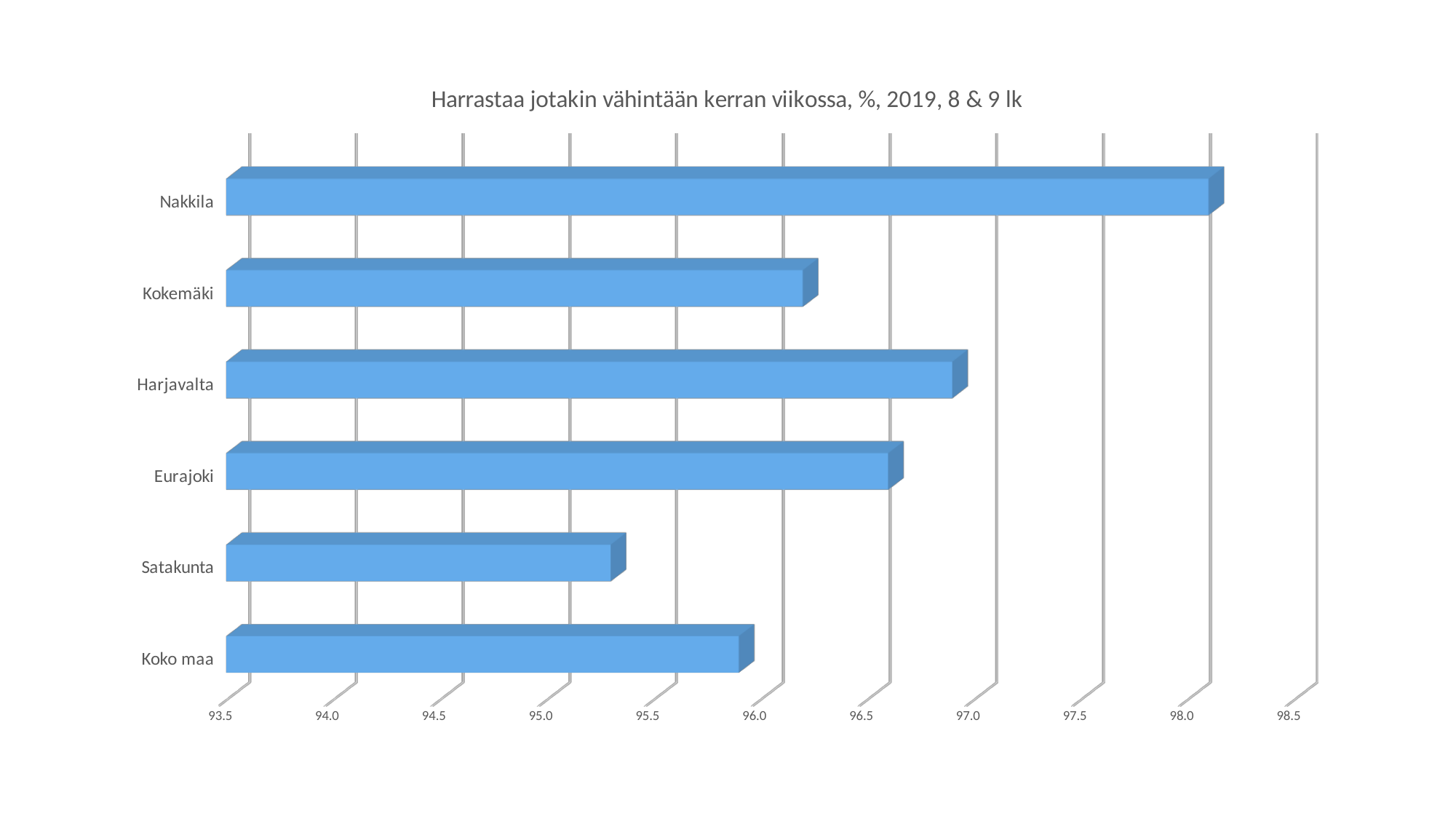
Is the value for Kokemäki greater or less than 96.5? less What is the title of the chart? Harrastaa jotakin vähintään kerran viikossa, %, 2019, 8 & 9 lk Is the value for Nakkila greater or less than 97.5? greater Which has the larger value, Harjavalta or Eurajoki? Harjavalta Which has the larger value, Kokemäki or Eurajoki? Eurajoki Which category has the highest value? Nakkila Is the value for Harjavalta greater or less than 97.0? less Which category has the lowest value? Satakunta What kind of chart is shown on the slide? bar chart How many categories are plotted in the chart? 6